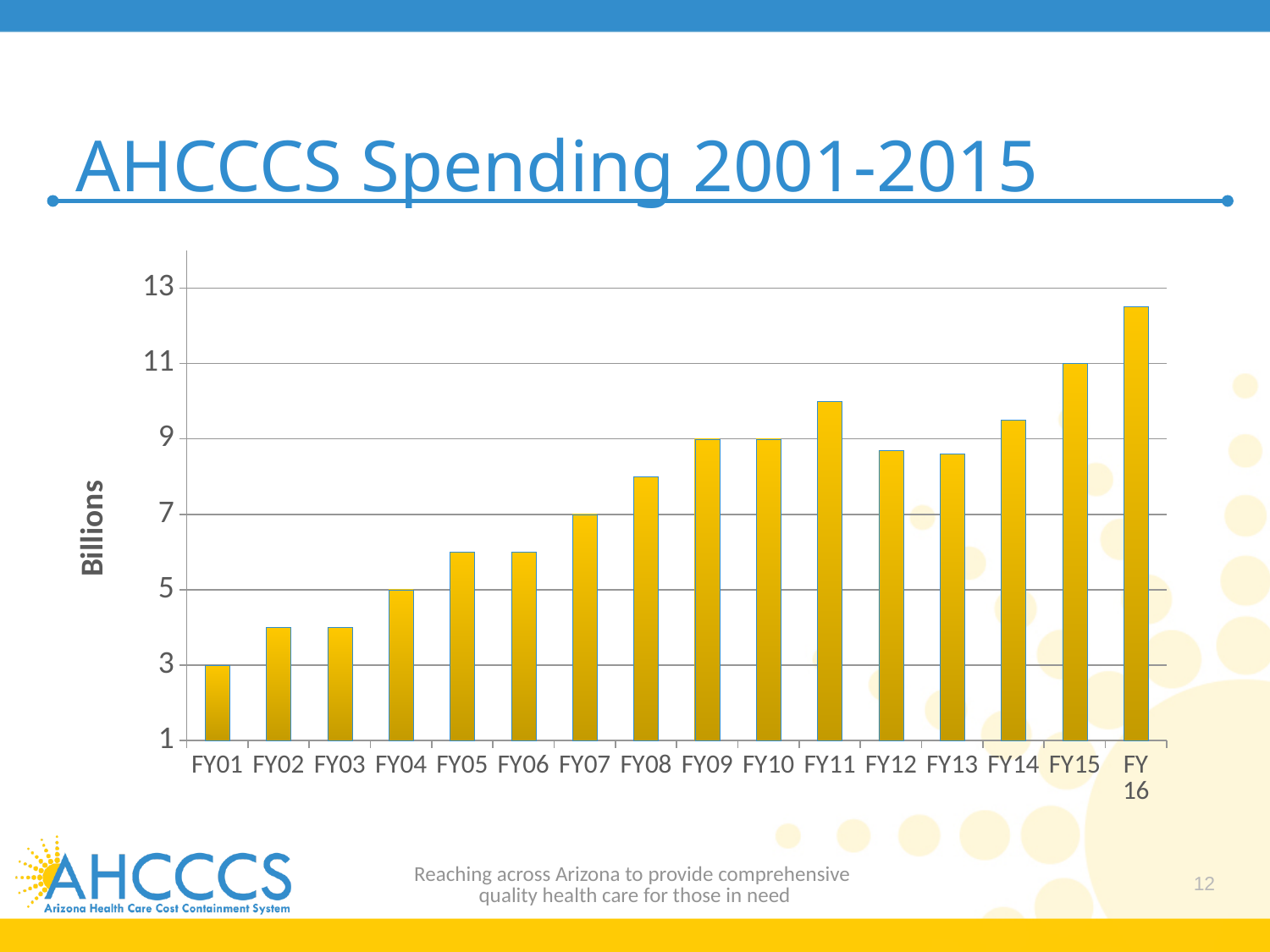
Is the value for FY16 greater or less than 11? greater Is the value for FY12 greater or less than 9? less What kind of chart is shown on the slide? Bar chart What is the spending value (in billions) for FY07? 7 Which is larger, the spending for FY11 or FY12? FY11 Which fiscal year has the highest spending in the chart? FY16 How many fiscal years are plotted in the chart? 16 What is the spending value (in billions) for FY01? 3 What is the label on the vertical axis of the chart? Billions What is the spending value (in billions) for FY15? 11 Do the spending values generally rise or fall from FY01 to FY16? Rise Which fiscal year has the lowest spending in the chart? FY01